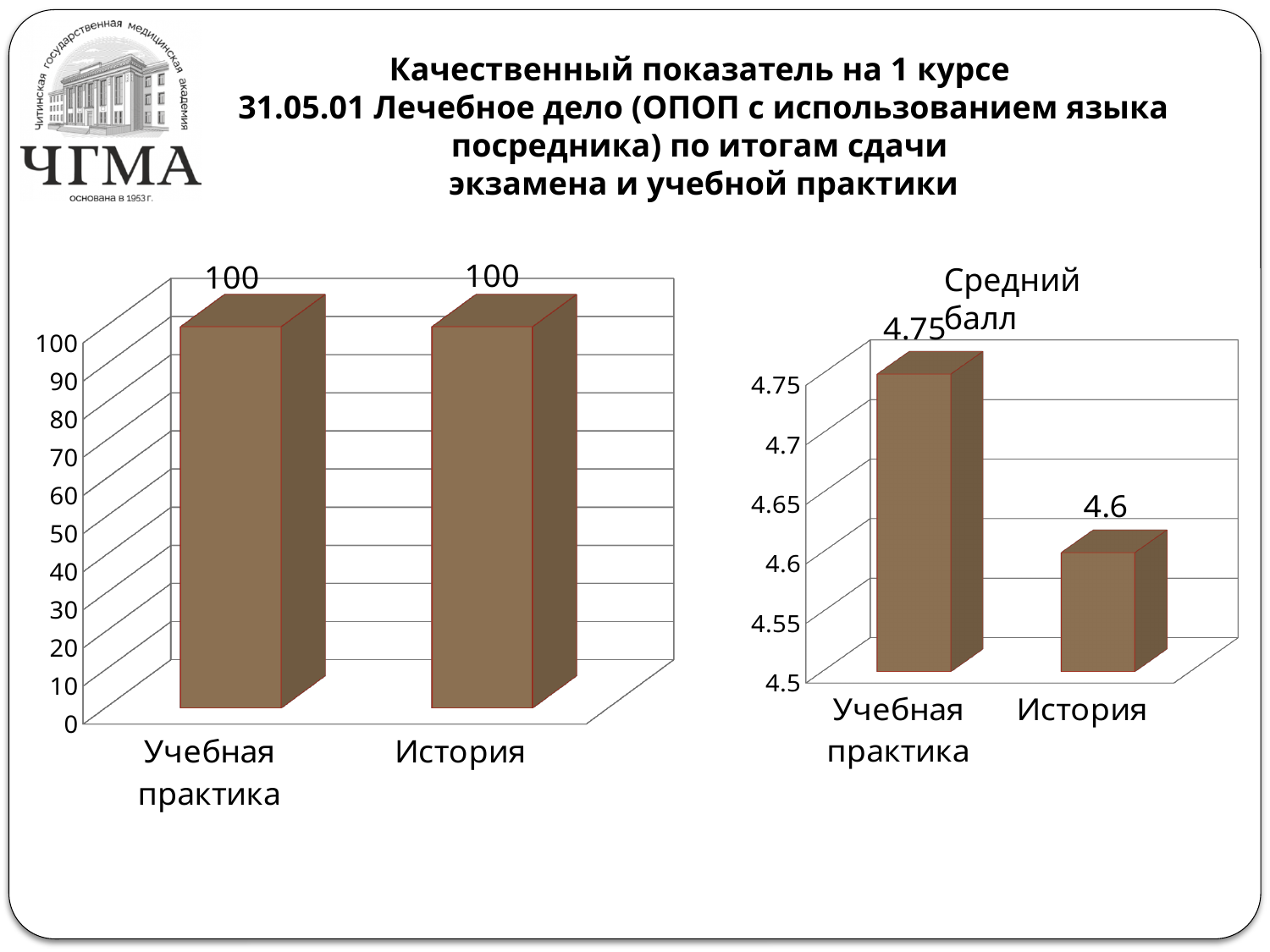
What is the title of the chart on the right side of the slide? Средний балл In the chart titled Средний балл, which is larger: the value for Учебная практика or the value for История? Учебная практика In the chart titled Средний балл, what is the value for История? 4.6 In the chart titled Средний балл, which category has the lowest value? История In the chart titled Средний балл, which category has the highest value? Учебная практика In the chart titled Средний балл, how many categories are shown? 2 What kind of chart is the chart titled Средний балл? Bar chart In the left chart, what is the value for Учебная практика? 100 In the chart titled Средний балл, what is the value for Учебная практика? 4.75 In the chart titled Средний балл, what is the difference between the values for Учебная практика and История? 0.15 In the left chart, what is the value for История? 100 In the left chart, how many categories are shown? 2